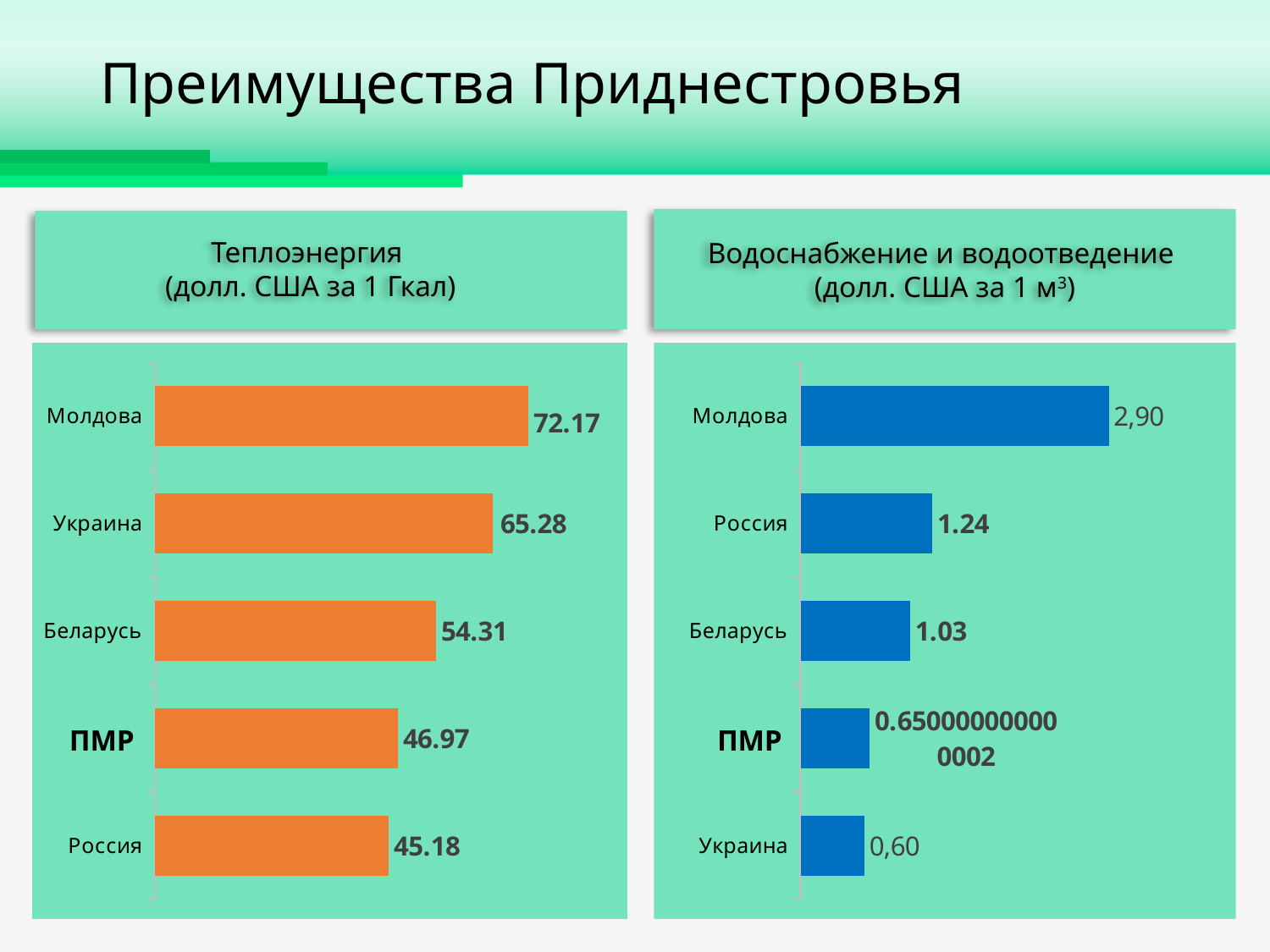
In the Теплоэнергия chart, which category has the lowest value? Россия In the Теплоэнергия chart, what is the difference between the values for Украина and Беларусь? 10.97 In the Водоснабжение и водоотведение chart, which category has the lowest value? Украина In the Теплоэнергия chart, how many categories are shown? 5 What type of chart is the Теплоэнергия chart? Bar chart In the Водоснабжение и водоотведение chart, which is larger, the value for Беларусь or the value for ПМР? Беларусь In the Теплоэнергия chart, what is the value for Молдова? 72.17 In the Водоснабжение и водоотведение chart, what is the value for Молдова? 2,90 In the Водоснабжение и водоотведение chart, what is the difference between the values for Россия and Беларусь? 0.21 In the Водоснабжение и водоотведение chart, what is the value for Россия? 1.24 In the Теплоэнергия chart, what is the value for ПМР? 46.97 In the Теплоэнергия chart, which category has the highest value? Молдова